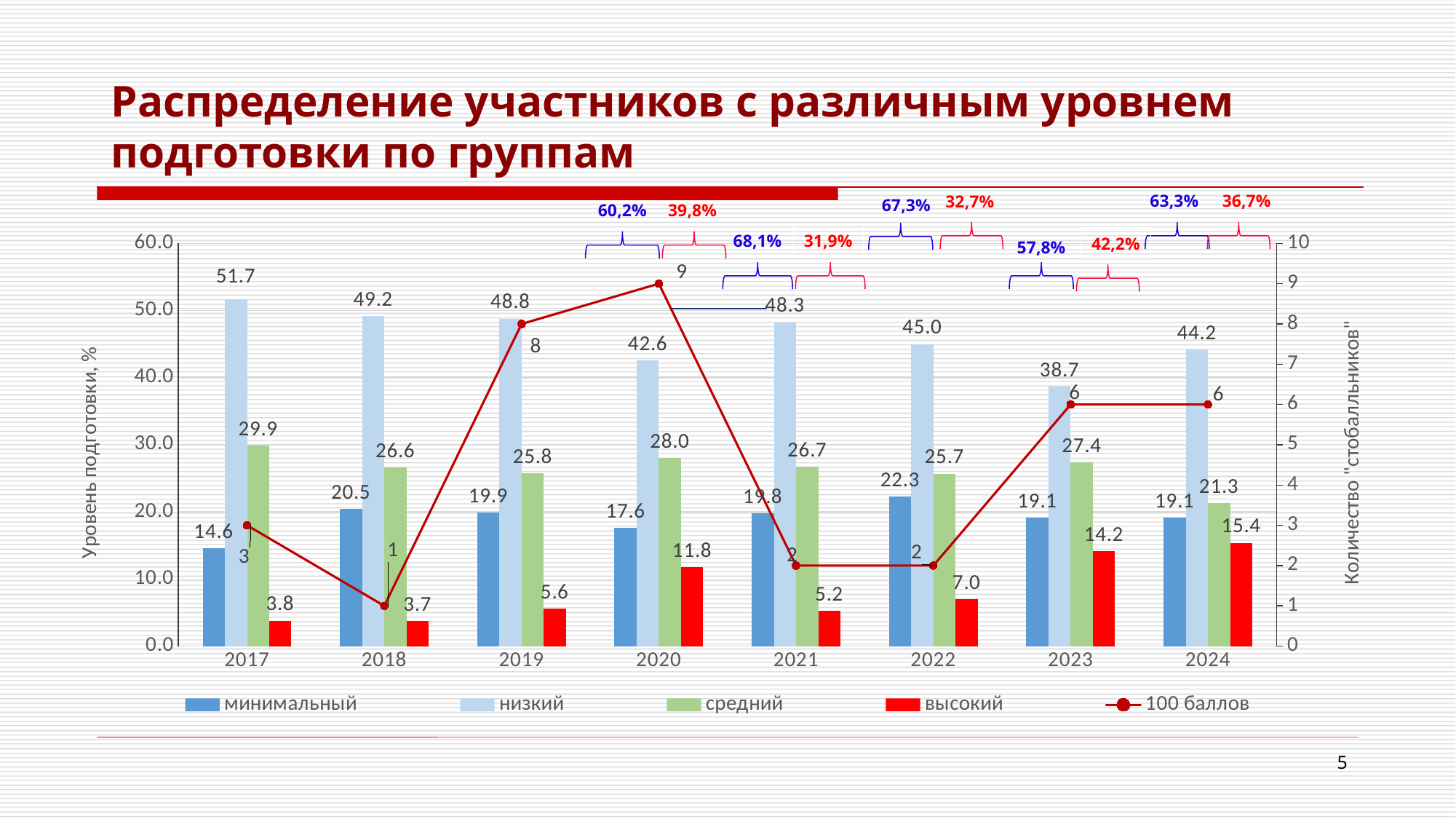
How many series does the legend list? 5 What kind of chart is this? Combined bar and line chart In which year is the "100 баллов" line lowest? 2018 What is the value of the "средний" series for 2021? 26.7 How many years are shown on the x axis? 8 What is the difference between the "низкий" values for 2017 and 2024? 7.5 What is the value of the "низкий" series for 2017? 51.7 How many "100 баллов" are shown for 2020? 9 Which series is drawn in red bars? высокий What is the value of the "высокий" series for 2024? 15.4 Which is larger: the "минимальный" value for 2022 or for 2018? 2022 In which year is the "высокий" series highest? 2024